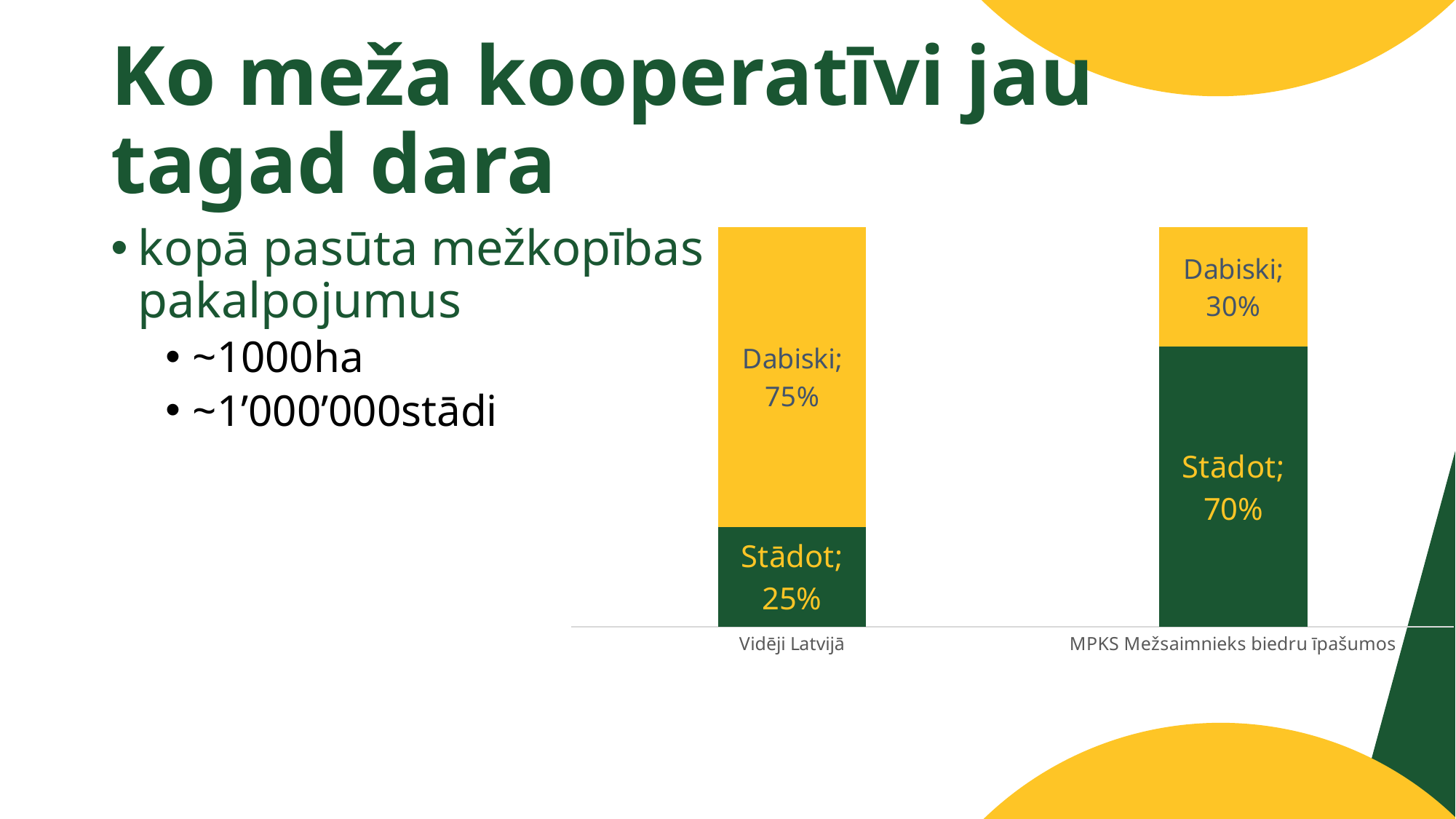
What kind of chart is shown on the slide? Stacked bar chart Which colour represents the Dabiski segment in the chart? Yellow What is the value for Dabiski in the MPKS Mežsaimnieks biedru īpašumos bar? 30% What is the value for Stādot in the Vidēji Latvijā bar? 25% What is the value for Dabiski in the Vidēji Latvijā bar? 75% What is the value for Stādot in the MPKS Mežsaimnieks biedru īpašumos bar? 70% Is the Dabiski value larger for Vidēji Latvijā or for MPKS Mežsaimnieks biedru īpašumos? Vidēji Latvijā How many categories are shown on the x axis of the chart? 2 What is the total of the stacked bar for Vidēji Latvijā? 100% Which category has the higher Stādot value? MPKS Mežsaimnieks biedru īpašumos Which category has the lower Dabiski value? MPKS Mežsaimnieks biedru īpašumos What is the difference between the Stādot values for MPKS Mežsaimnieks biedru īpašumos and Vidēji Latvijā? 45%